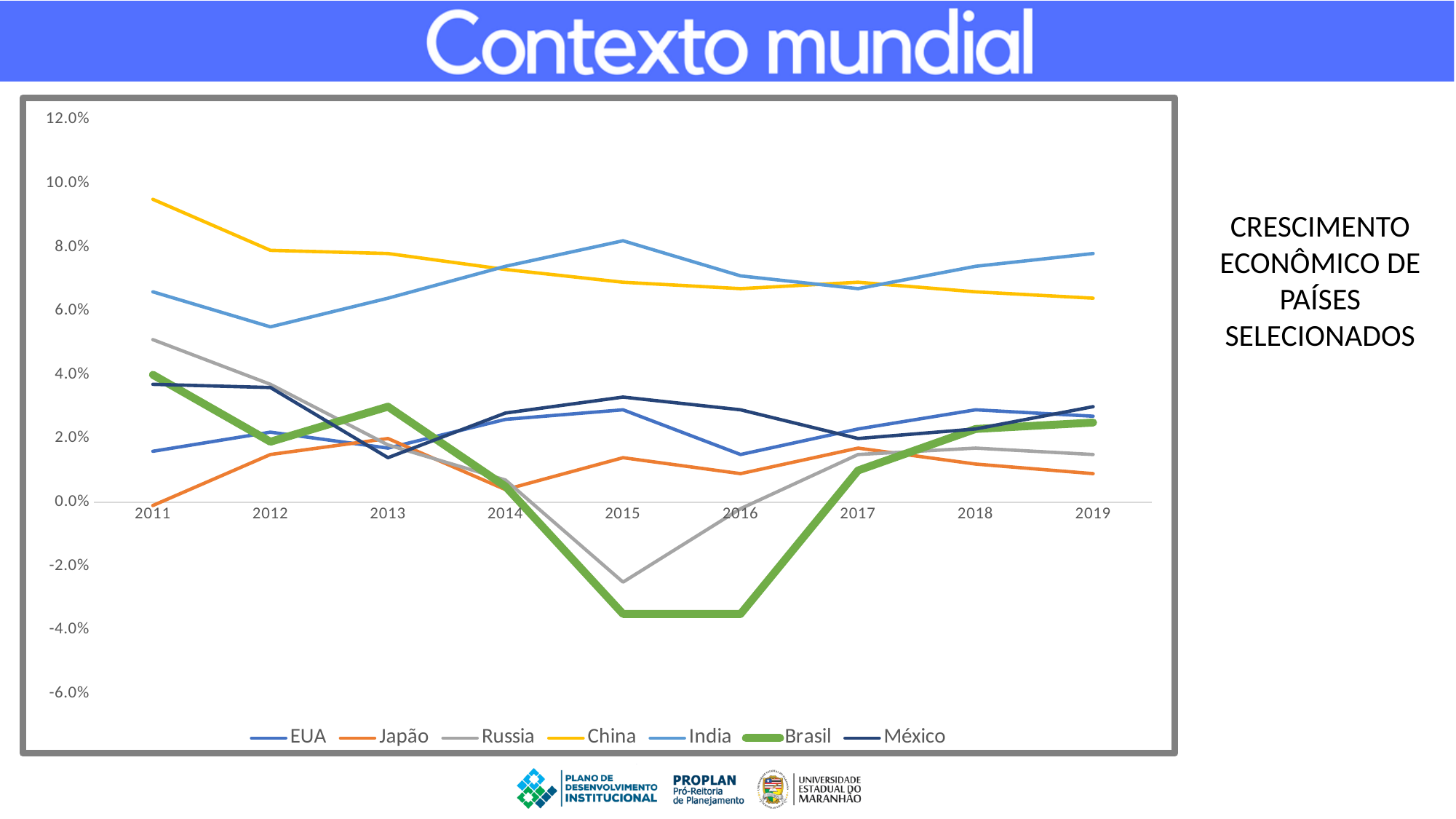
Which country has the highest value in 2015? India Is the value for Brasil in 2015 greater or less than -2.0%? less Does China's line rise or fall overall from 2011 to 2019? fall Which country has the highest value in 2011? China How many series does the legend list? 7 In 2019, which is higher, India or China? India What is the title text shown to the right of the chart? CRESCIMENTO ECONÔMICO DE PAÍSES SELECIONADOS Is the value for India in 2012 greater or less than 6.0%? less What kind of chart is shown on the slide? line chart Which country has the lowest value in 2015? Brasil How many years are plotted along the x axis? 9 Is the value for China in 2011 greater or less than 8.0%? greater